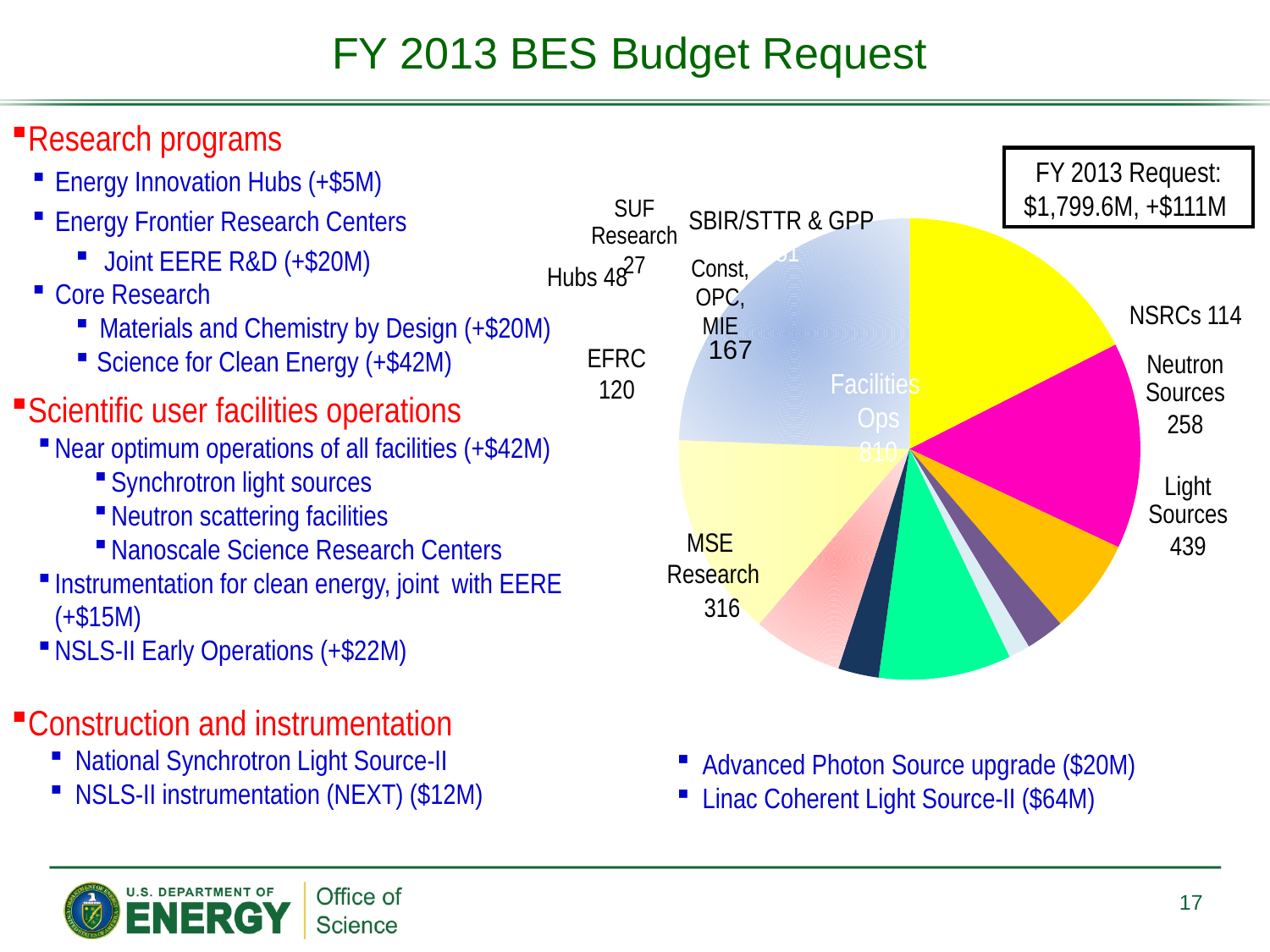
What value is shown for Const, OPC, MIE in the pie chart? 167 What value is shown for EFRC in the pie chart? 120 What total FY 2013 request amount is shown in the box next to the pie chart? $1,799.6M, +$111M What value is shown for MSE Research in the pie chart? 316 What value is shown for NSRCs in the pie chart? 114 What is the difference between the Light Sources value and the Neutron Sources value in the pie chart? 181 What is the difference between the MSE Research value and the EFRC value in the pie chart? 196 Which has the larger value in the pie chart, Light Sources or Neutron Sources? Light Sources What kind of chart is shown on the slide? Pie chart What value is shown for Neutron Sources in the pie chart? 258 What value is shown for Hubs in the pie chart? 48 What value is shown for Light Sources in the pie chart? 439